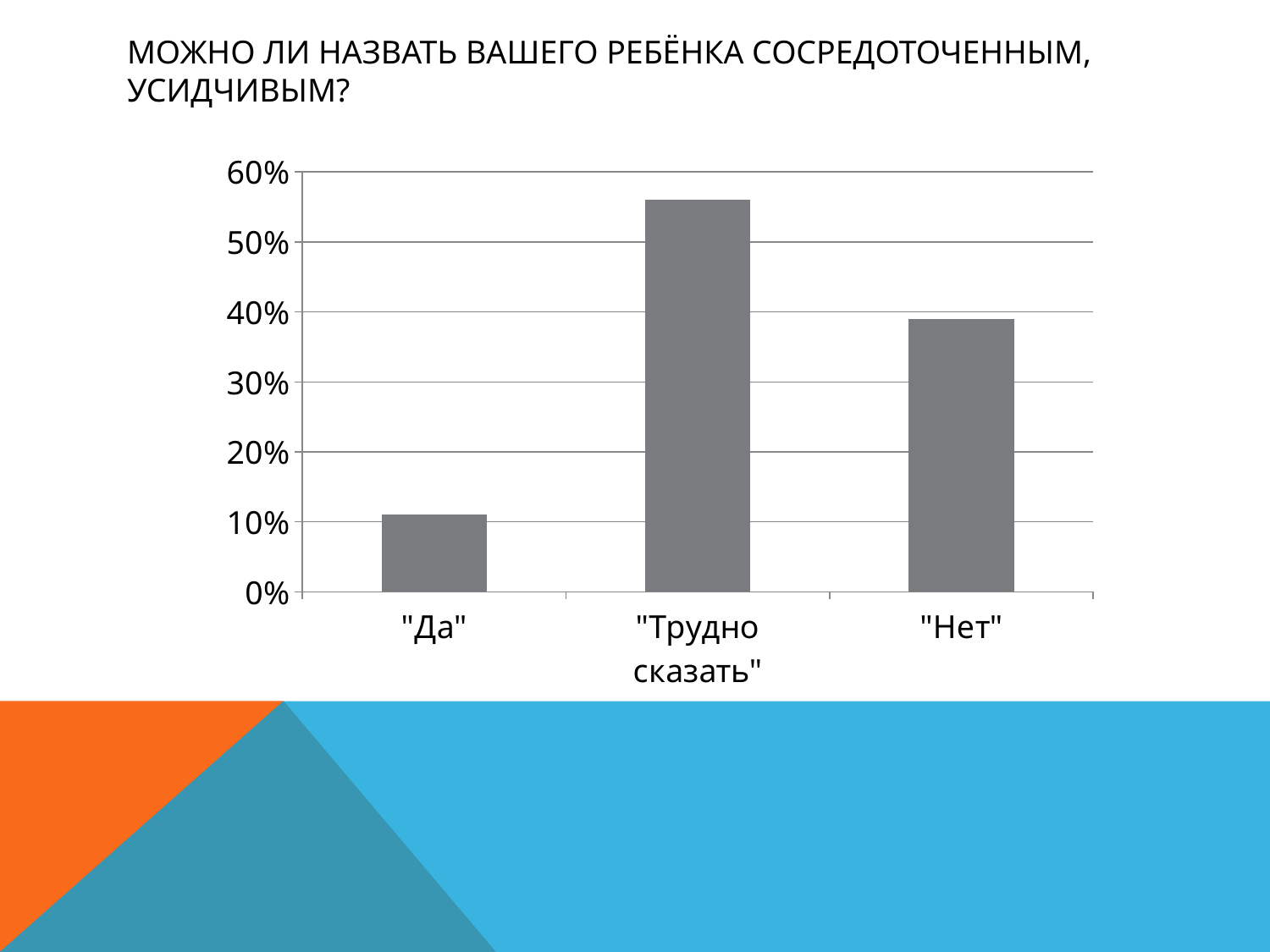
How many categories are shown on the x axis of the chart? 3 What question is the chart on the slide about, according to the slide title? Можно ли назвать вашего ребёнка сосредоточенным, усидчивым? What kind of chart is shown on the slide? bar chart Is the value for "Трудно сказать" greater or less than 50%? greater Which is larger, the value for "Нет" or the value for "Да"? "Нет" Which category has the lowest bar in the chart? "Да" Is the value for "Нет" greater or less than 30%? greater What is the highest value shown on the vertical axis of the chart? 60% Is the value for "Да" greater or less than 20%? less Which is larger, the value for "Трудно сказать" or the value for "Нет"? "Трудно сказать" Which category has the highest bar in the chart? "Трудно сказать"